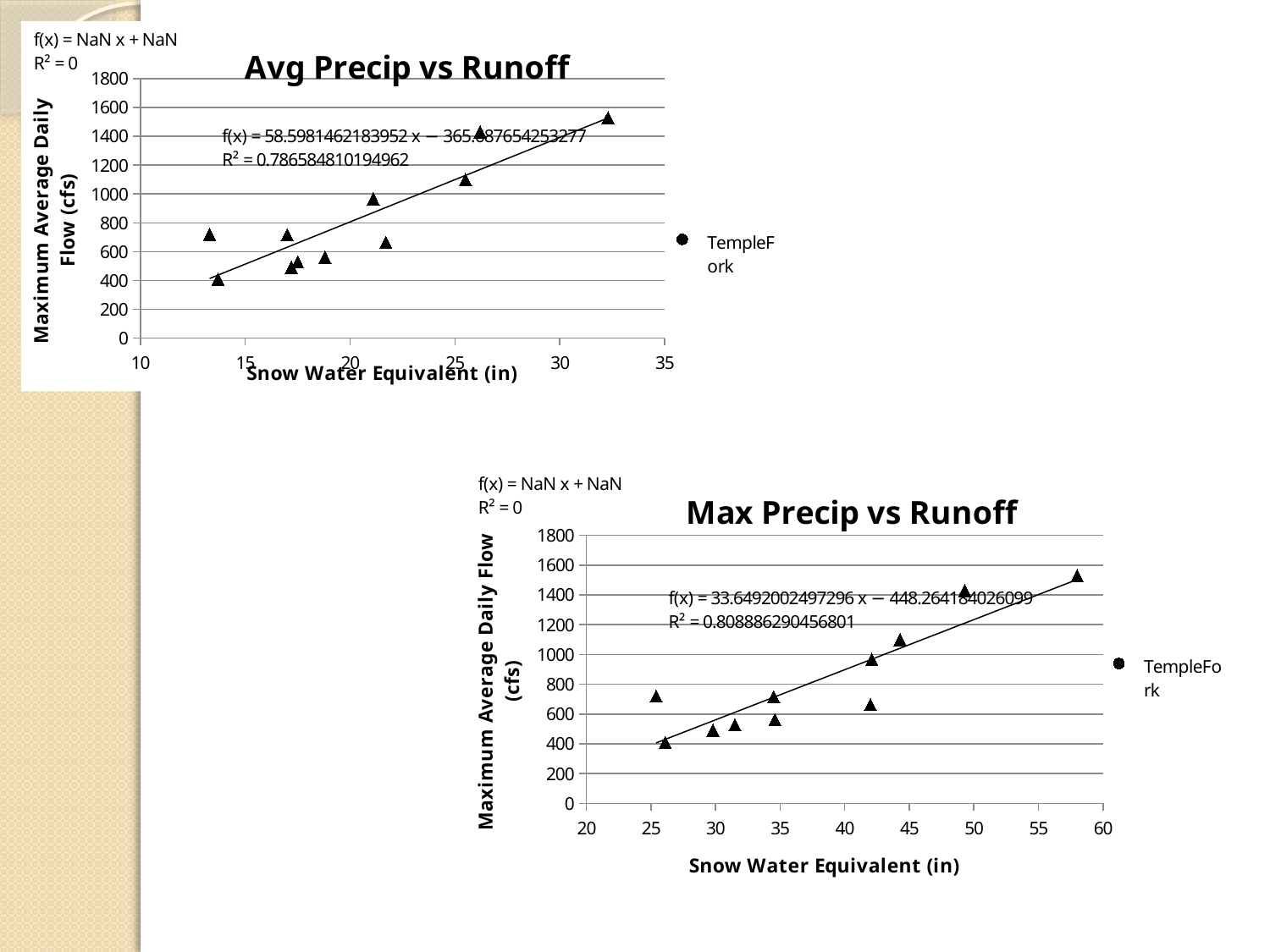
In the 'Max Precip vs Runoff' chart, what is the R² value of the fitted trend line shown inside the plot area? 0.808886290456801 What series name appears in the legend of the 'Avg Precip vs Runoff' chart? TempleFork Which chart has the higher R² value for its fitted trend line, 'Avg Precip vs Runoff' or 'Max Precip vs Runoff'? Max Precip vs Runoff In the 'Avg Precip vs Runoff' chart, do the Maximum Average Daily Flow values generally rise or fall as Snow Water Equivalent increases? rise What kind of chart is the 'Max Precip vs Runoff' chart? scatter chart What kind of chart is the 'Avg Precip vs Runoff' chart? scatter chart In the 'Max Precip vs Runoff' chart, do the Maximum Average Daily Flow values generally rise or fall as Snow Water Equivalent increases? rise How many series does the legend of the 'Max Precip vs Runoff' chart list? 1 What is the x-axis label of the 'Avg Precip vs Runoff' chart? Snow Water Equivalent (in) In the 'Avg Precip vs Runoff' chart, what is the R² value of the fitted trend line shown inside the plot area? 0.786584810194962 In the 'Max Precip vs Runoff' chart, is the flow value for the point with the smallest Snow Water Equivalent greater or less than 1000? less In the 'Avg Precip vs Runoff' chart, is the flow value for the point with the largest Snow Water Equivalent greater or less than 1400? greater